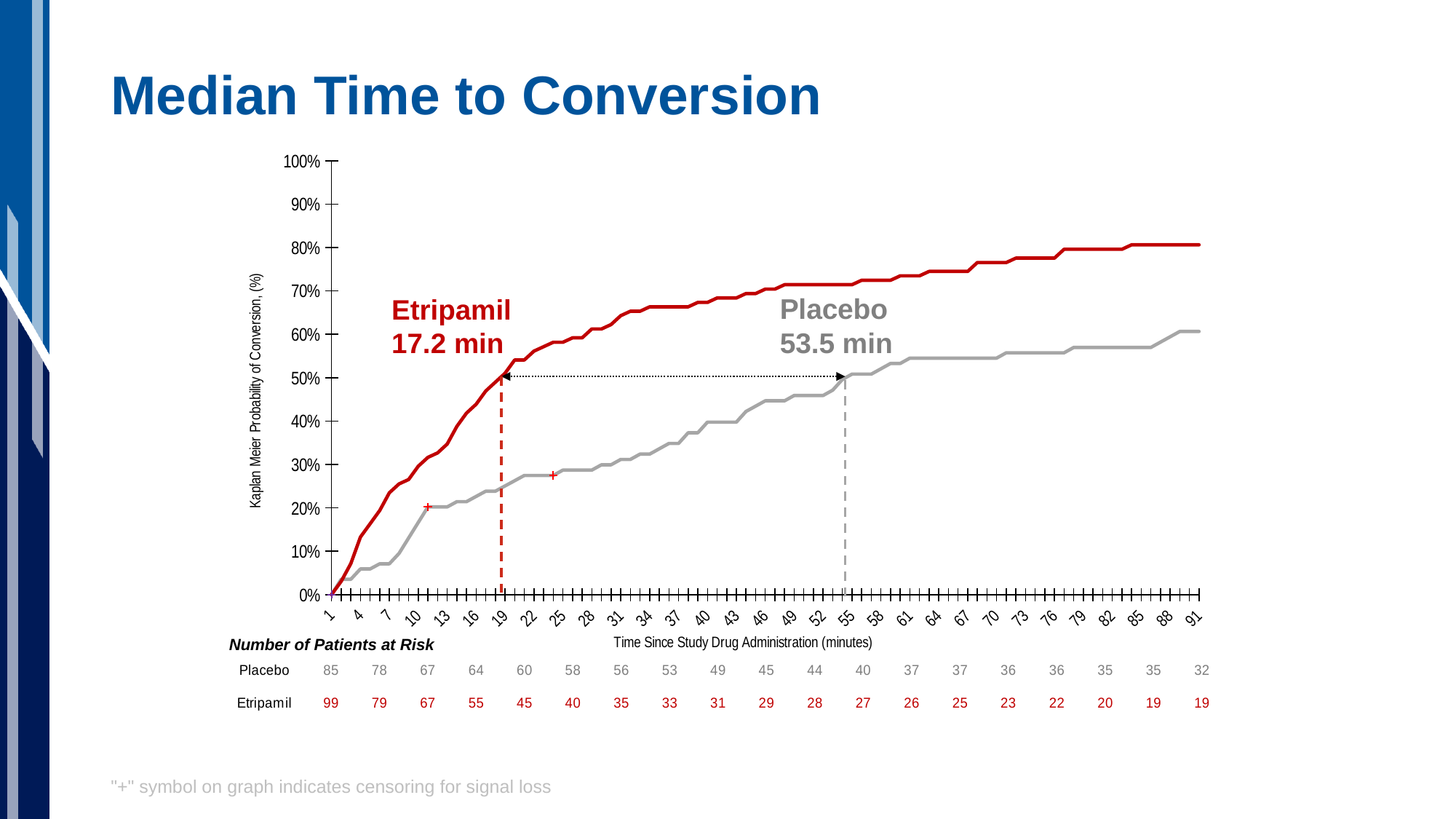
Do the probability of conversion curves rise or fall as time since drug administration increases? rise What is the median time to conversion for Etripamil? 17.2 min What colour is the Etripamil curve on the chart? red What is the difference between the Placebo and Etripamil median times to conversion? 36.3 min At 19 minutes, is the Placebo probability of conversion greater or less than 30%? less What is the median time to conversion for Placebo? 53.5 min How many patients were at risk in the Etripamil group at the first time point in the Number of Patients at Risk table? 99 How many treatment groups (series) are plotted on the chart? 2 At 91 minutes, is the Etripamil probability of conversion greater or less than 70%? greater Which group has the shorter median time to conversion, Etripamil or Placebo? Etripamil What kind of chart is shown on the slide? line chart How many patients were at risk in the Placebo group at the first time point in the Number of Patients at Risk table? 85